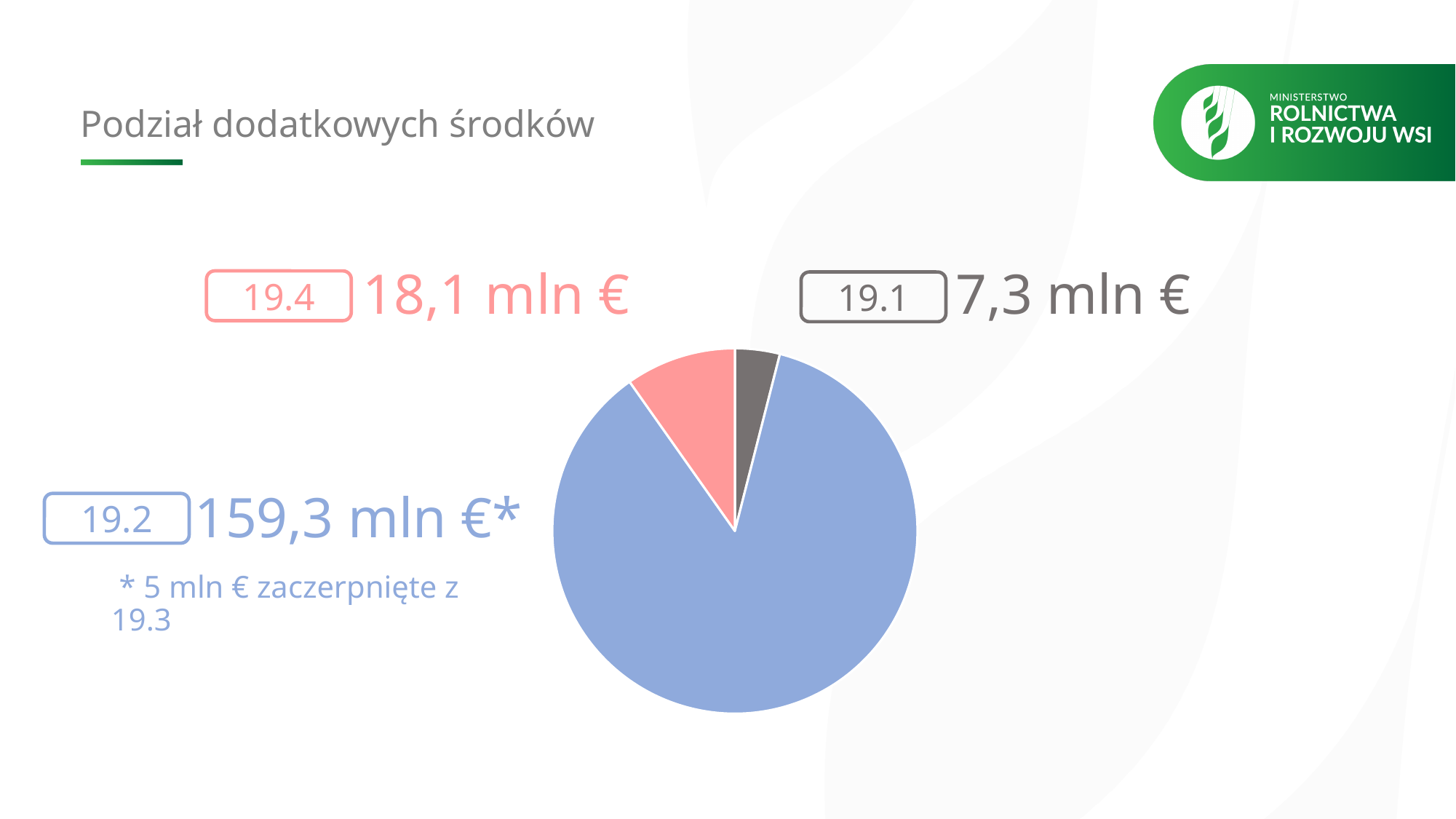
What kind of chart is shown on the slide? pie chart Which is larger, the value for 19.4 or the value for 19.1? 19.4 What is the value for 19.4? 18,1 mln € What is the value for 19.1? 7,3 mln € What is the difference between the values for 19.4 and 19.1? 10,8 mln € Which category has the largest slice of the pie? 19.2 Which category has the smallest slice of the pie? 19.1 What is the title of the slide's chart? Podział dodatkowych środków What is the value for 19.2? 159,3 mln € What colour is the slice for 19.1? grey What is the difference between the values for 19.2 and 19.4? 141,2 mln € How many slices does the pie chart have? 3